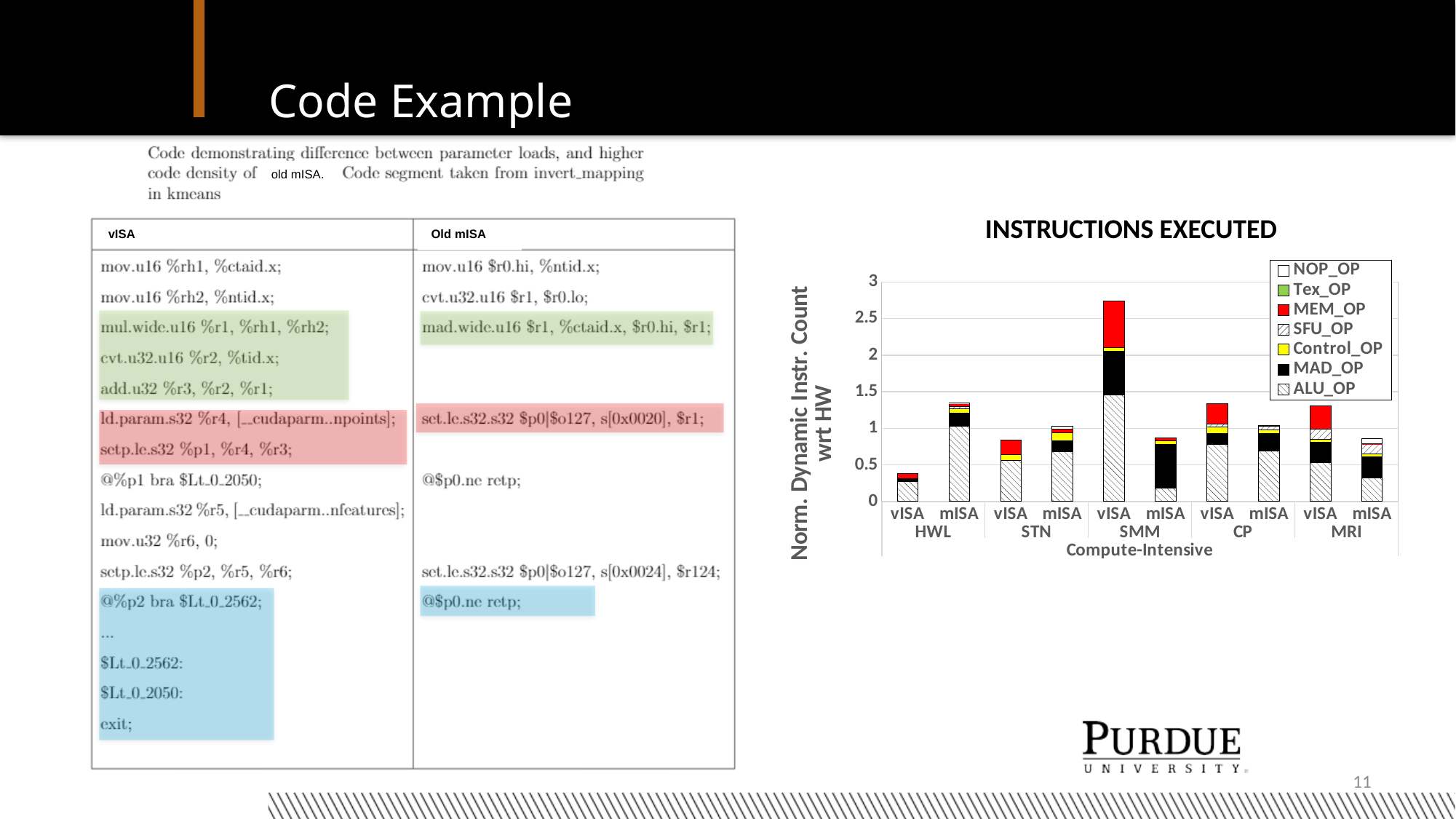
What is the label of the y axis of the chart? Norm. Dynamic Instr. Count wrt HW Which is larger, the total for vISA or mISA in the SMM group? vISA What is the title of the chart? INSTRUCTIONS EXECUTED Which bar has the highest total in the chart? vISA for SMM Is the total for the HWL mISA bar greater or less than 1? greater How many bars are plotted in the chart? 10 What kind of chart is shown on the slide? stacked bar chart Which bar has the lowest total in the chart? vISA for HWL How many series does the chart's legend list? 7 Which is larger, the total for vISA or mISA in the HWL group? mISA Is the total for the HWL vISA bar greater or less than 0.5? less Is the total for the SMM vISA bar greater or less than 2.5? greater